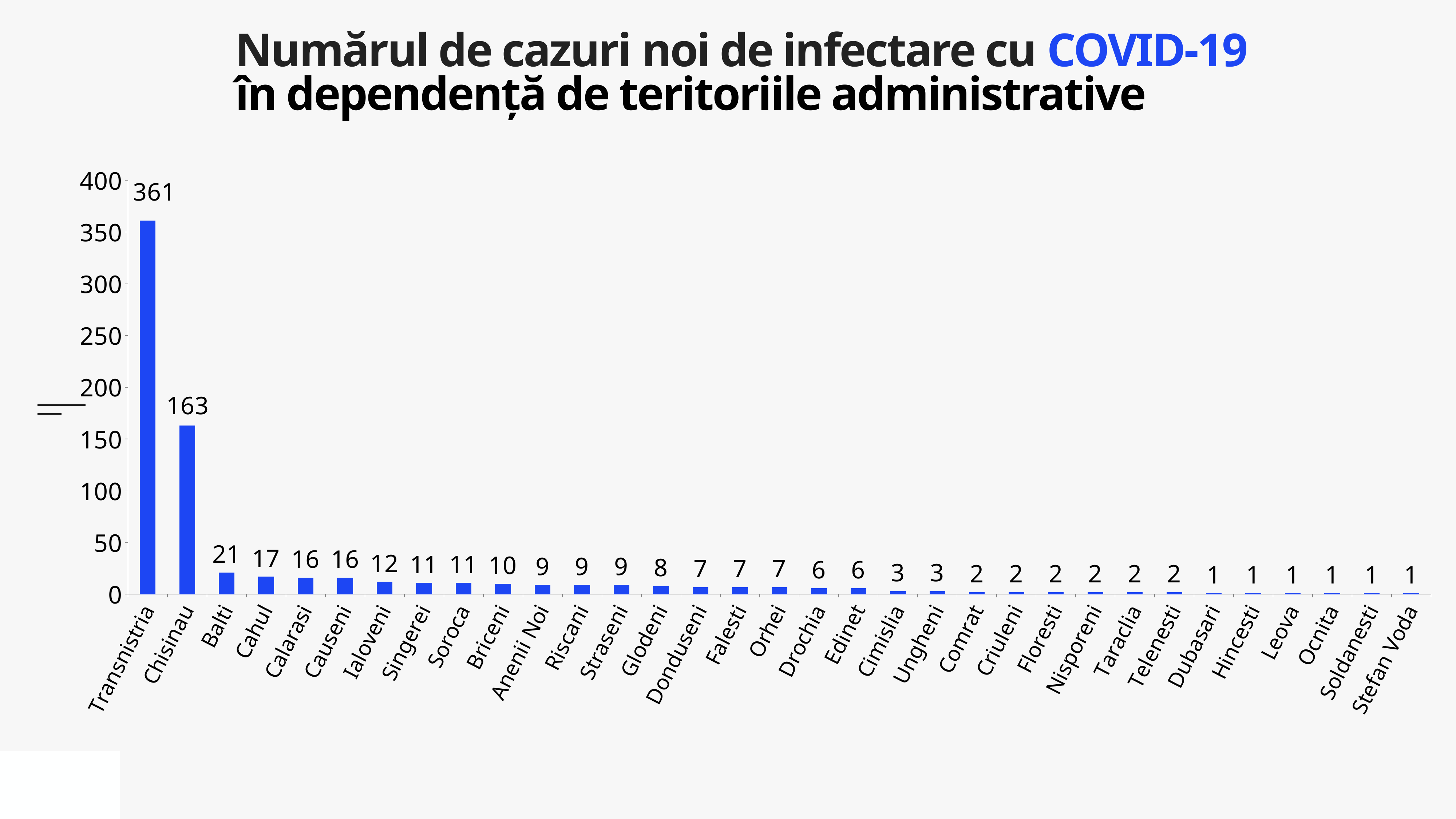
What kind of chart is shown on the slide? Bar chart What is the value for Ialoveni? 12 Which territory has the highest number of new cases? Transnistria How many territories are shown on the x axis? 33 What is the value for Transnistria? 361 Which is larger, the value for Cahul or the value for Soroca? Cahul What is the value for Balti? 21 What is the difference between the values for Balti and Cahul? 4 What is the difference between the values for Transnistria and Chisinau? 198 Is the value for Chisinau greater or less than 150? greater What is the value for Chisinau? 163 Do the values rise or fall from left to right along the x axis? Fall